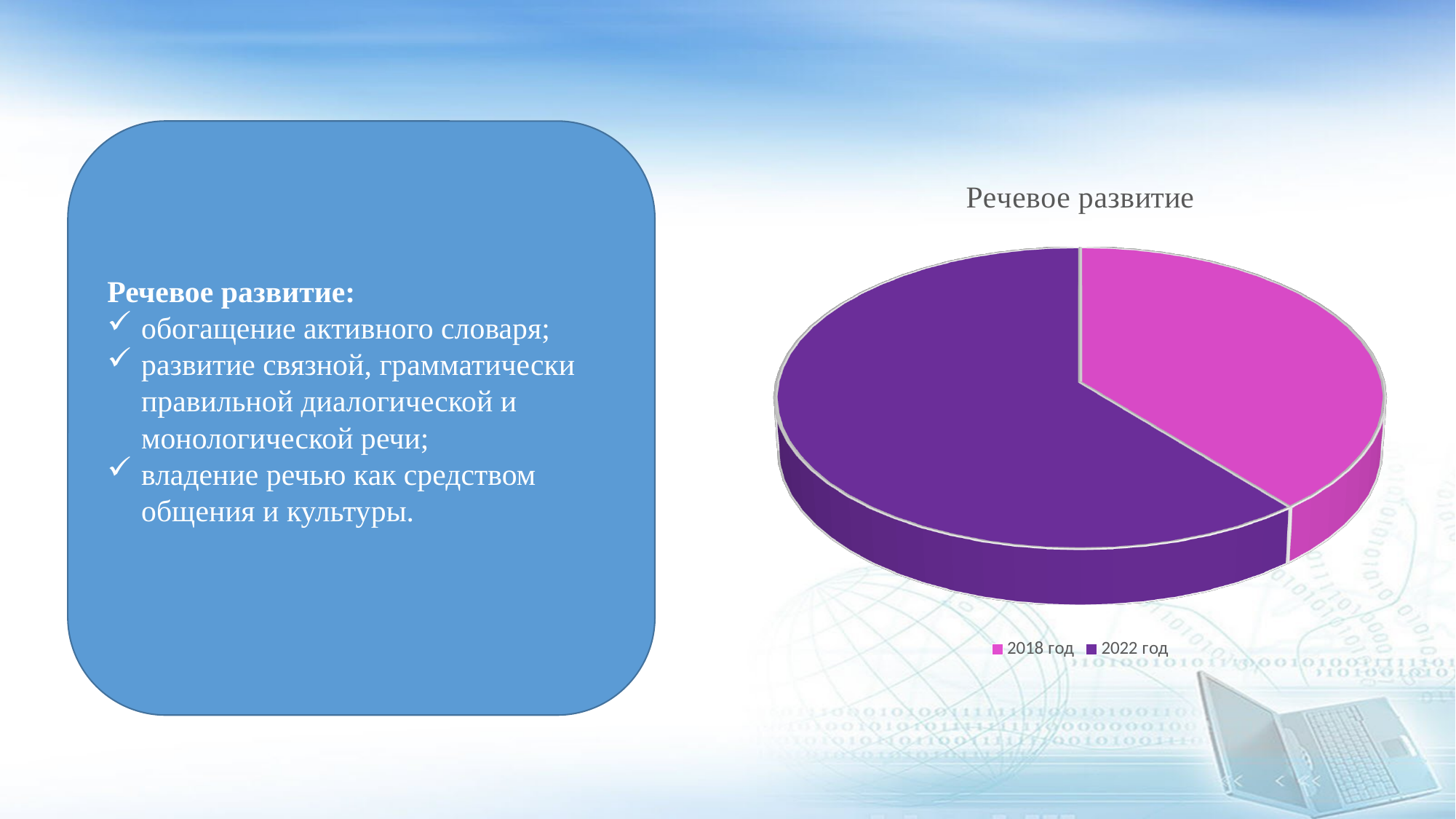
What is the title of the chart? Речевое развитие How many entries does the chart legend list? 2 Which slice of the pie chart is the largest? 2022 год Which slice of the pie chart is the smallest? 2018 год What kind of chart is shown on the slide? pie chart What colour is the slice for 2018 год? pink (magenta) Does the slice for 2022 год take up more or less than half of the pie? more Which slice is larger, 2018 год or 2022 год? 2022 год How many slices does the pie chart have? 2